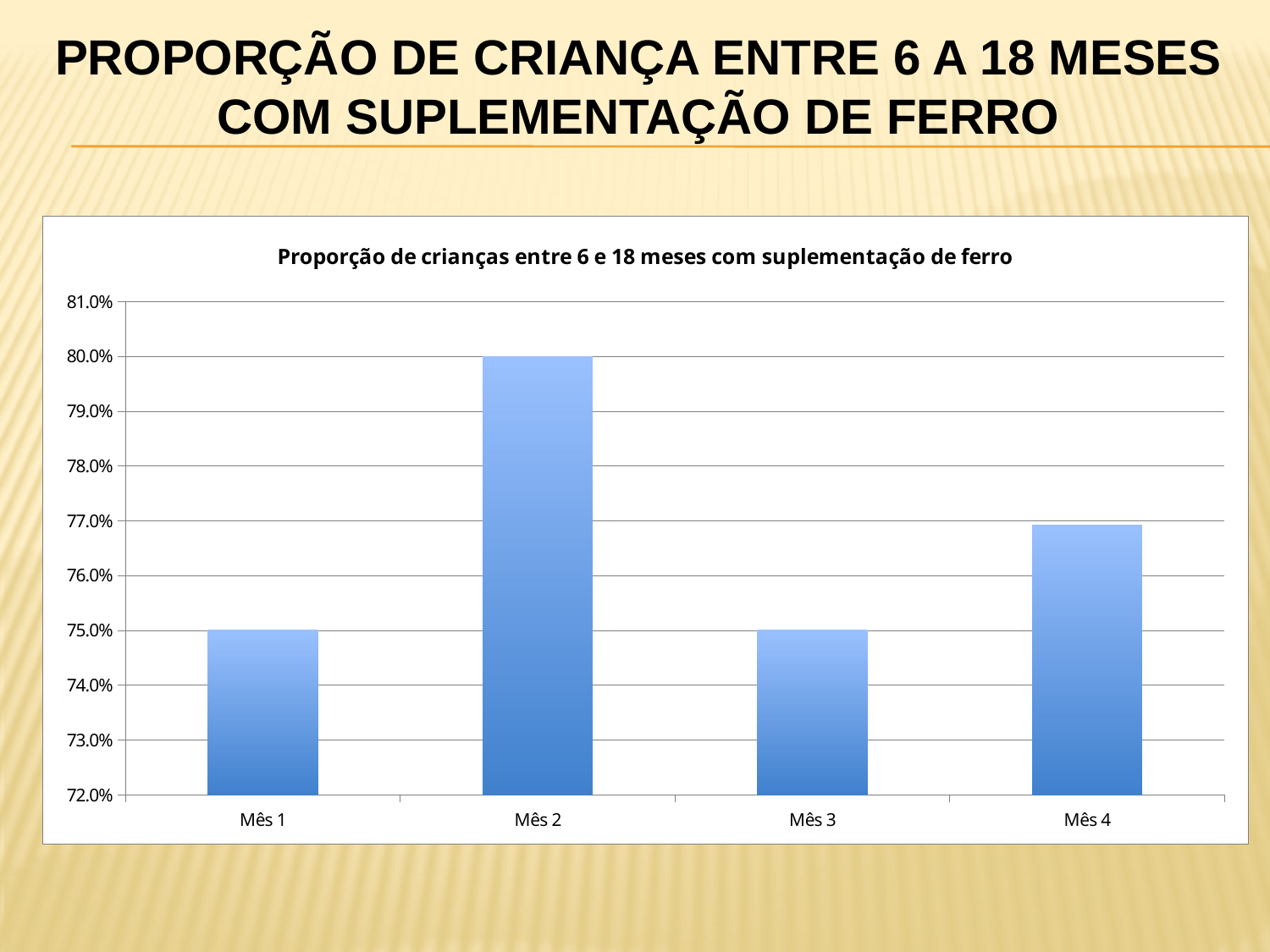
What is the difference between the values for Mês 2 and Mês 1? 5.0% Which is larger, the value for Mês 2 or the value for Mês 4? Mês 2 Which month has the highest proportion? Mês 2 What is the value for Mês 3? 75.0% What is the value for Mês 2? 80.0% Which is larger, the value for Mês 4 or the value for Mês 3? Mês 4 What type of chart is shown on the slide? bar chart What is the title printed inside the chart area? Proporção de crianças entre 6 e 18 meses com suplementação de ferro Is the value for Mês 4 greater or less than 76.0%? greater How many months (categories) are shown on the x axis of the chart? 4 What is the value for Mês 1? 75.0%